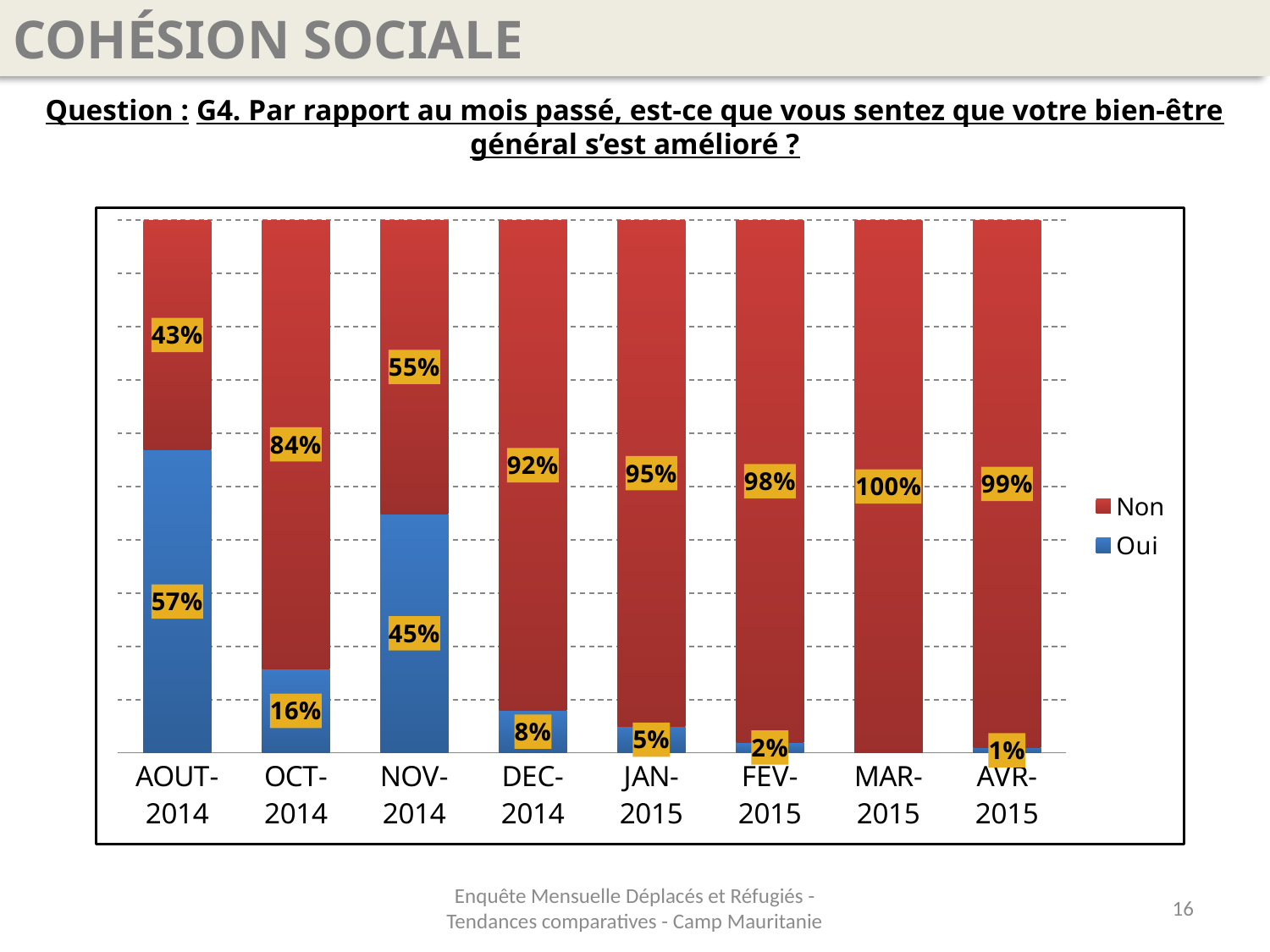
What is the value for Non in MAR-2015? 100% Which is larger, the Oui value for OCT-2014 or the Oui value for JAN-2015? OCT-2014 How many series does the legend list? 2 What is the value for Non in AOUT-2014? 43% What is the value for Oui in DEC-2014? 8% How many months are shown on the x axis? 8 In which month is the Non value lowest? AOUT-2014 Does the Non value generally rise or fall from AOUT-2014 to MAR-2015? Rise What is the value for Oui in NOV-2014? 45% In which month is the Oui value highest? AOUT-2014 What kind of chart is shown on the slide? Stacked bar chart What is the difference between the Non values for OCT-2014 and NOV-2014? 29%